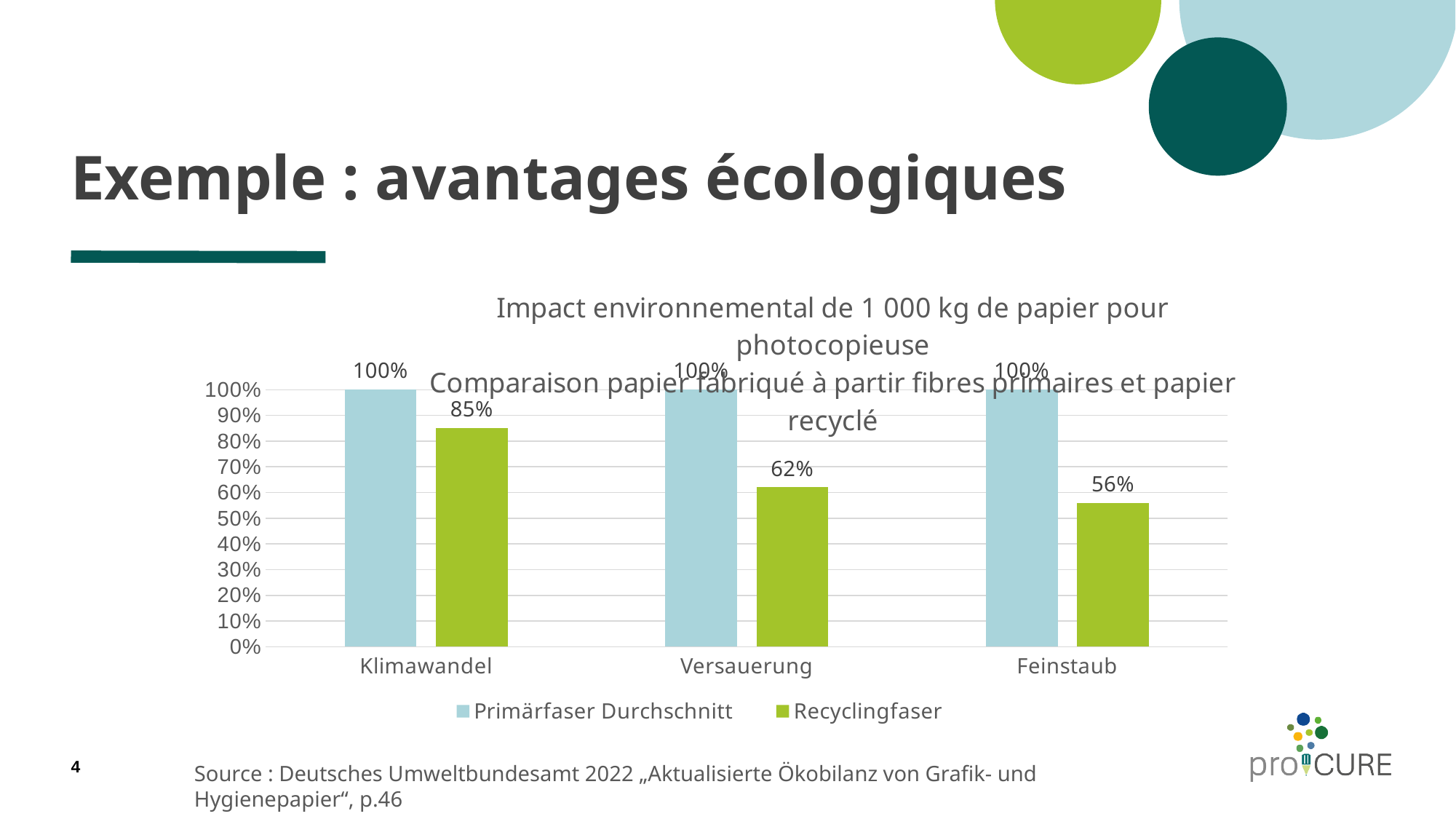
What is the value for Recyclingfaser in the Klimawandel category? 85% Which is larger in the Feinstaub category: Primärfaser Durchschnitt or Recyclingfaser? Primärfaser Durchschnitt What is the value for Recyclingfaser in the Versauerung category? 62% Do the Recyclingfaser values rise or fall from Klimawandel to Feinstaub? Fall What kind of chart is shown on the slide? Bar chart How many categories are shown on the x axis? 3 What is the difference between Primärfaser Durchschnitt and Recyclingfaser in the Versauerung category? 38% What is the value for Primärfaser Durchschnitt in the Feinstaub category? 100% In which category is the Recyclingfaser value lowest? Feinstaub In which category is the Recyclingfaser value highest? Klimawandel How many series does the legend list? 2 What is the value for Recyclingfaser in the Feinstaub category? 56%